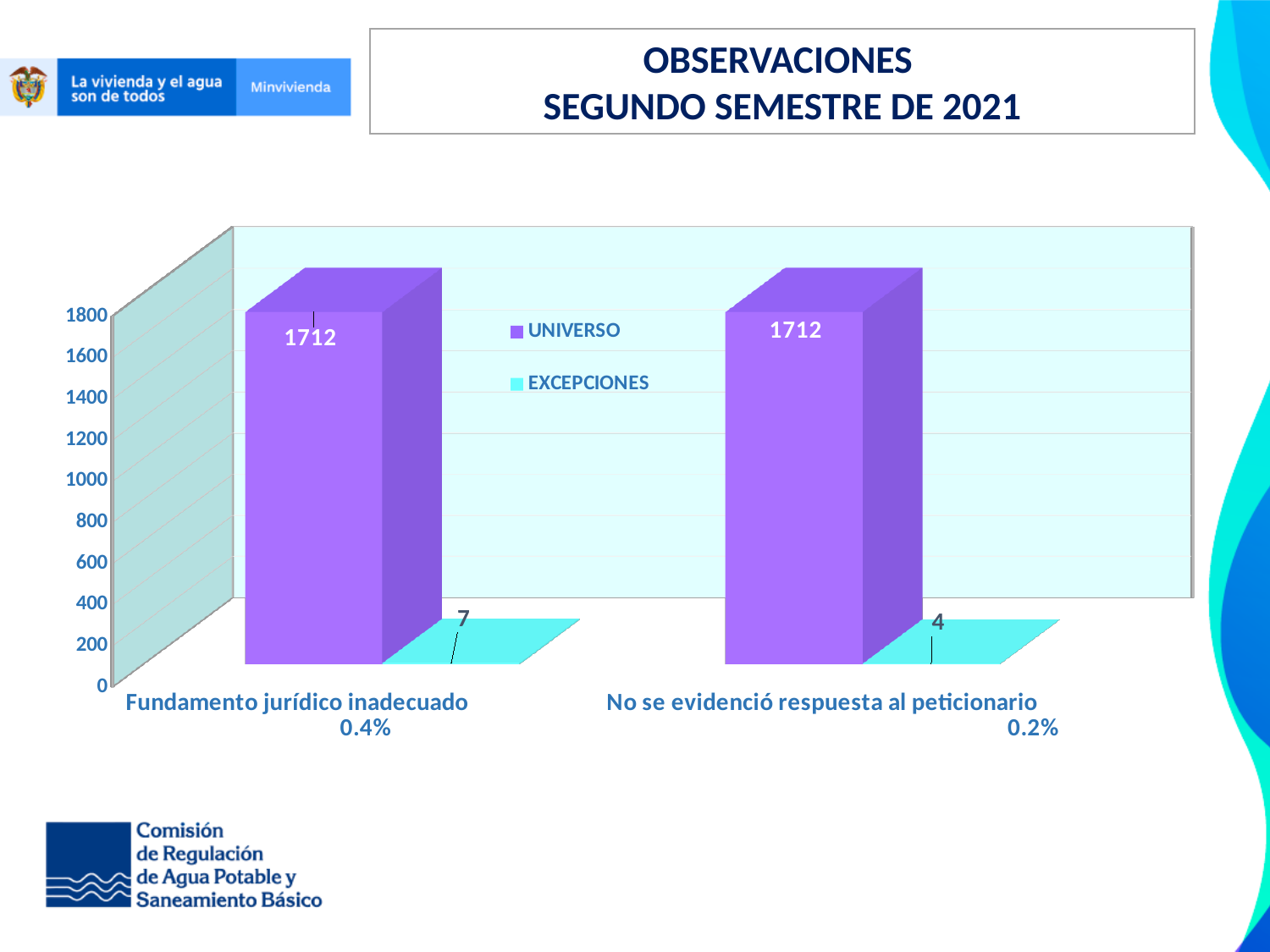
What is the EXCEPCIONES value for "No se evidenció respuesta al peticionario"? 4 Which category has the higher EXCEPCIONES value? Fundamento jurídico inadecuado How many categories are shown on the x axis of the chart? 2 What is the UNIVERSO value for "Fundamento jurídico inadecuado"? 1712 What type of chart is shown on the slide? bar chart Is the EXCEPCIONES value for "Fundamento jurídico inadecuado" larger or smaller than the EXCEPCIONES value for "No se evidenció respuesta al peticionario"? larger How many series does the chart legend list? 2 What is the EXCEPCIONES value for "Fundamento jurídico inadecuado"? 7 What is the UNIVERSO value for "No se evidenció respuesta al peticionario"? 1712 Which category has the lower EXCEPCIONES value? No se evidenció respuesta al peticionario What is the difference between the UNIVERSO and EXCEPCIONES values for "Fundamento jurídico inadecuado"? 1705 What is the difference between the EXCEPCIONES values for "Fundamento jurídico inadecuado" and "No se evidenció respuesta al peticionario"? 3